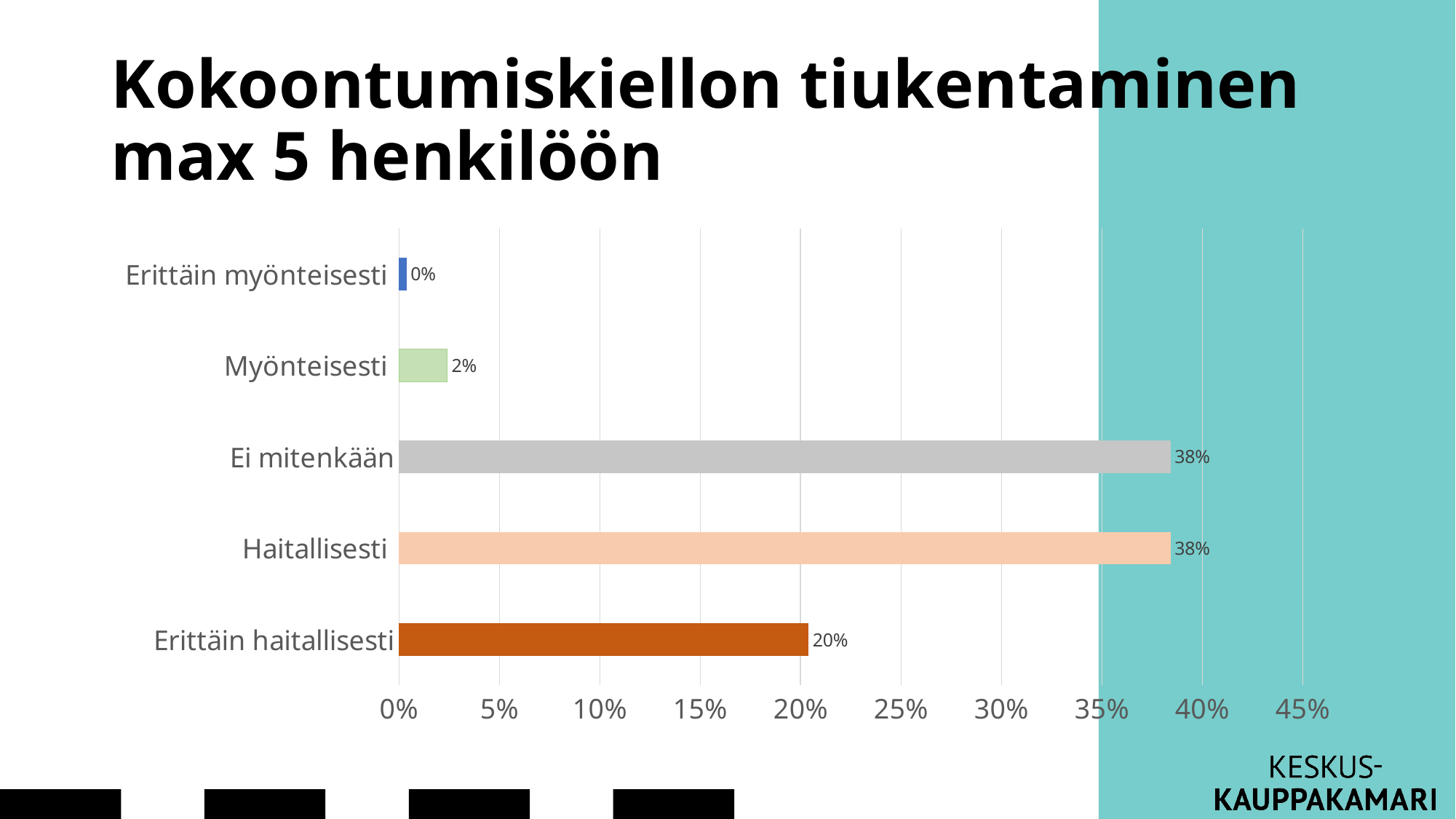
What is the value for Erittäin myönteisesti? 0% What colour is the bar for Erittäin haitallisesti? dark orange What is the title of the slide? Kokoontumiskiellon tiukentaminen max 5 henkilöön What is the value for Myönteisesti? 2% Which is larger, the value for Erittäin haitallisesti or the value for Myönteisesti? Erittäin haitallisesti Is the value for Haitallisesti greater or less than 35%? greater What kind of chart is shown on the slide? bar chart How many categories are shown in the chart? 5 Which category has the lowest value? Erittäin myönteisesti What is the value for Erittäin haitallisesti? 20% What is the difference between the values for Haitallisesti and Erittäin haitallisesti? 18% What is the value for Ei mitenkään? 38%